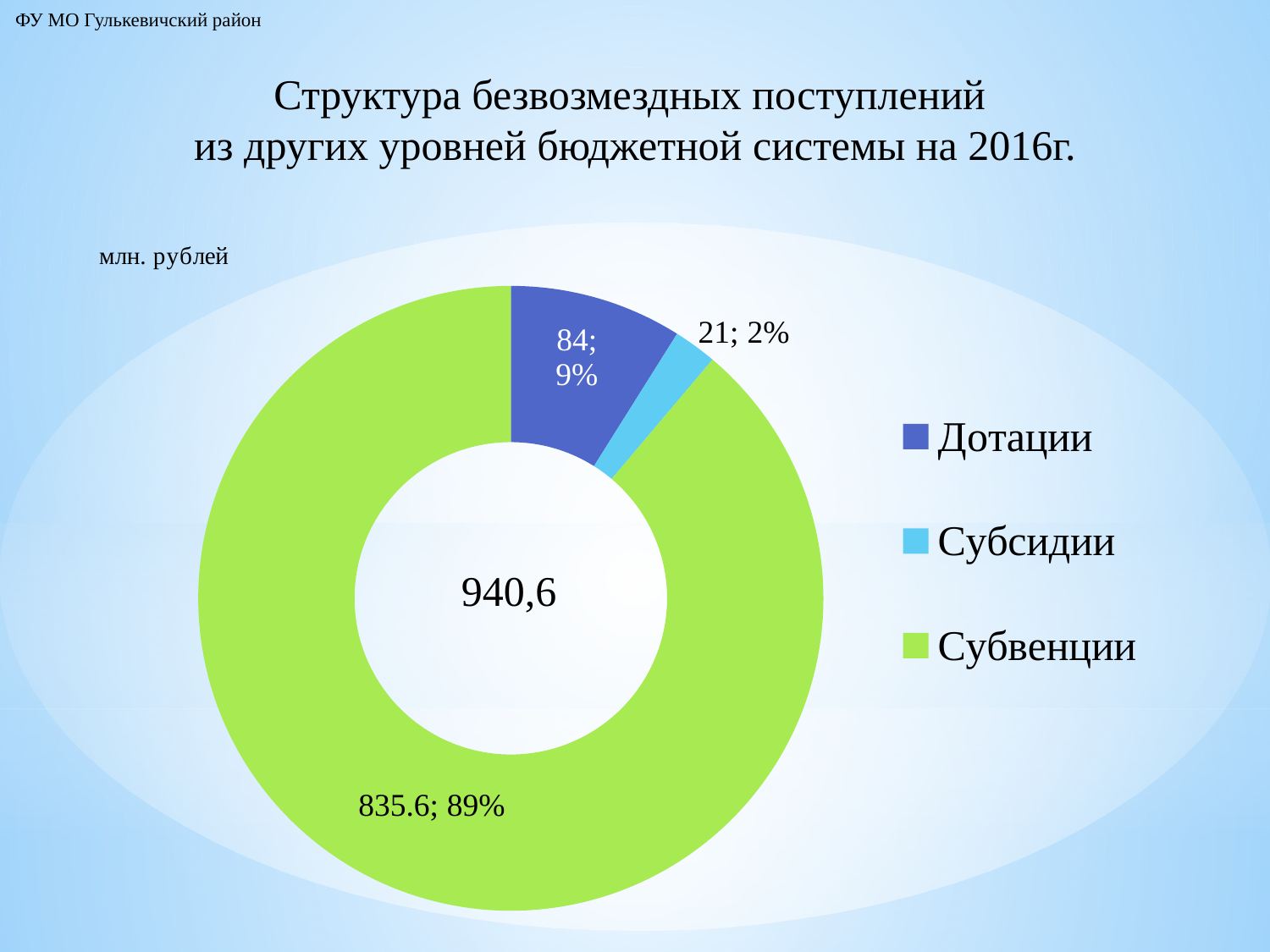
Which category has the largest share of the chart? Субвенции What type of chart is shown on the slide? Doughnut chart What is the value for Дотации? 84 What is the difference between the values for Субвенции and Дотации? 751.6 Which category has the smallest share of the chart? Субсидии How many categories does the chart show? 3 Which is larger, the value for Дотации or the value for Субсидии? Дотации What is the value for Субсидии? 21 What percentage share does Субвенции have? 89% What percentage share does Дотации have? 9% What total value is shown in the centre of the chart? 940,6 What is the value for Субвенции? 835.6